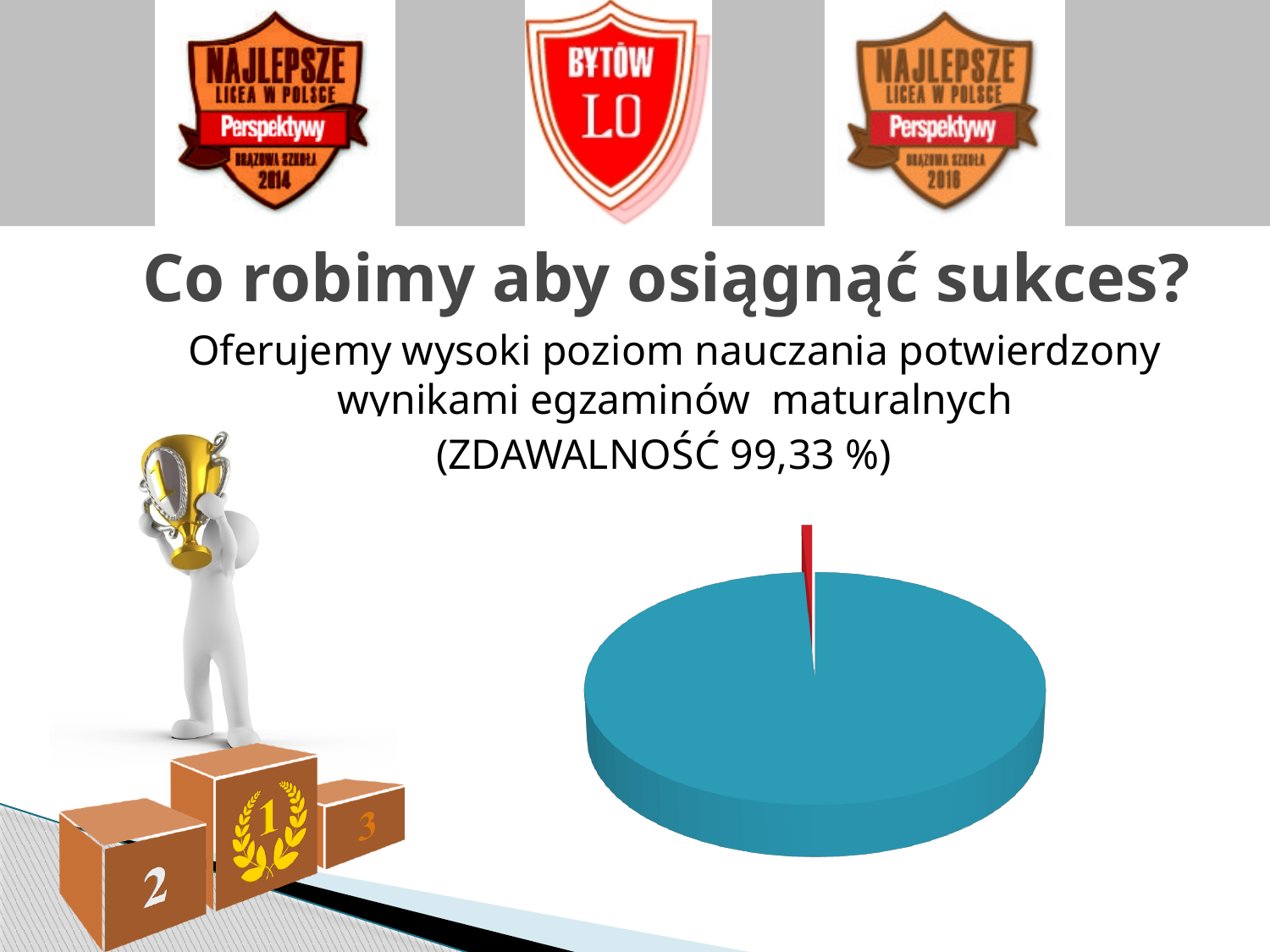
In the pie chart, is the blue slice larger or smaller than the red slice? larger What kind of chart is shown on the slide? pie chart What two colours are used for the slices of the pie chart? blue and red How many slices does the pie chart have? 2 Which slice of the pie chart is the largest, the blue one or the red one? the blue one Which slice of the pie chart is the smallest, the blue one or the red one? the red one Does the pie chart show a legend? no